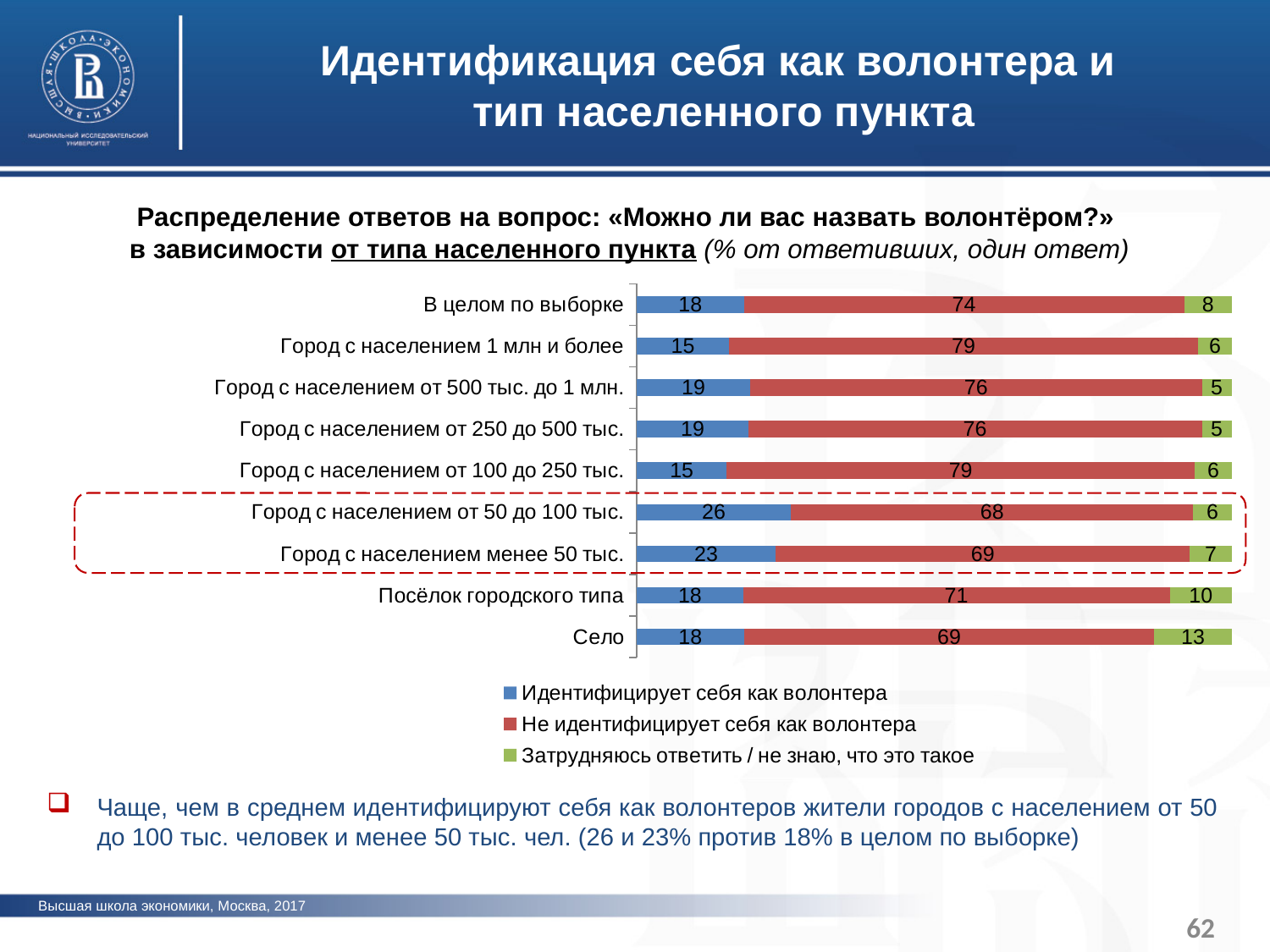
What kind of chart is shown on the slide? Stacked bar chart Which category has the highest value for «Идентифицирует себя как волонтера»? Город с населением от 50 до 100 тыс. What is the value of «Затрудняюсь ответить / не знаю, что это такое» for «Село»? 13 Which series is shown in red on the chart? Не идентифицирует себя как волонтера What is the value of «Не идентифицирует себя как волонтера» for «В целом по выборке»? 74 What is the difference between the «Идентифицирует себя как волонтера» values for «Город с населением от 50 до 100 тыс.» and «В целом по выборке»? 8 Which is larger: the «Не идентифицирует себя как волонтера» value for «Город с населением 1 млн и более» or for «Посёлок городского типа»? Город с населением 1 млн и более How many series does the legend list? 3 How many categories (types of settlement) are shown on the chart? 9 Which category has the highest value for «Затрудняюсь ответить / не знаю, что это такое»? Село What is the value of «Идентифицирует себя как волонтера» for «Город с населением от 50 до 100 тыс.»? 26 What is the total of the stacked bar for «Посёлок городского типа»? 99